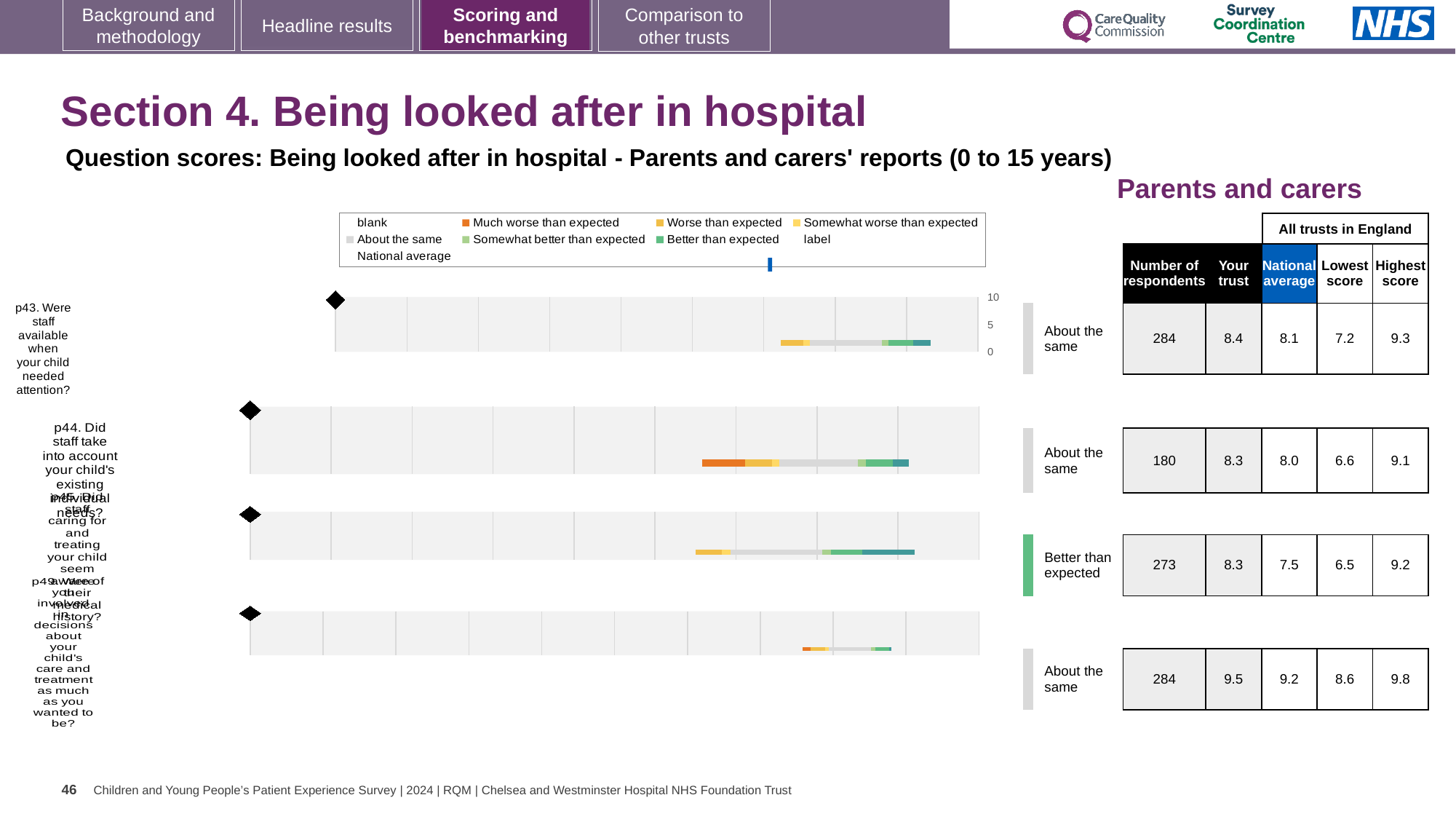
What is the lowest score across all trusts in England for p44? 6.6 What is the national average score for p44 (Did staff take into account your child's existing individual needs?)? 8.0 Which question is rated 'Better than expected' rather than 'About the same'? p45 How many questions (bars) are plotted on the slide? 4 What kind of chart is used to show the question scores on this slide? bar chart For p45, which is larger: the 'Your trust' score or the national average? Your trust Which question has the lowest national average score? p45 How many respondents are shown for p45 (Did staff caring for and treating your child seem aware of their medical history?)? 273 Which question has the highest 'Your trust' score? p49 What is the 'Your trust' score for p43 (Were staff available when your child needed attention?)? 8.4 What is the highest score across all trusts in England for p49 (Were you involved in decisions about your child's care and treatment as much as you wanted to be?)? 9.8 What is the difference between the 'Your trust' score and the national average for p43? 0.3